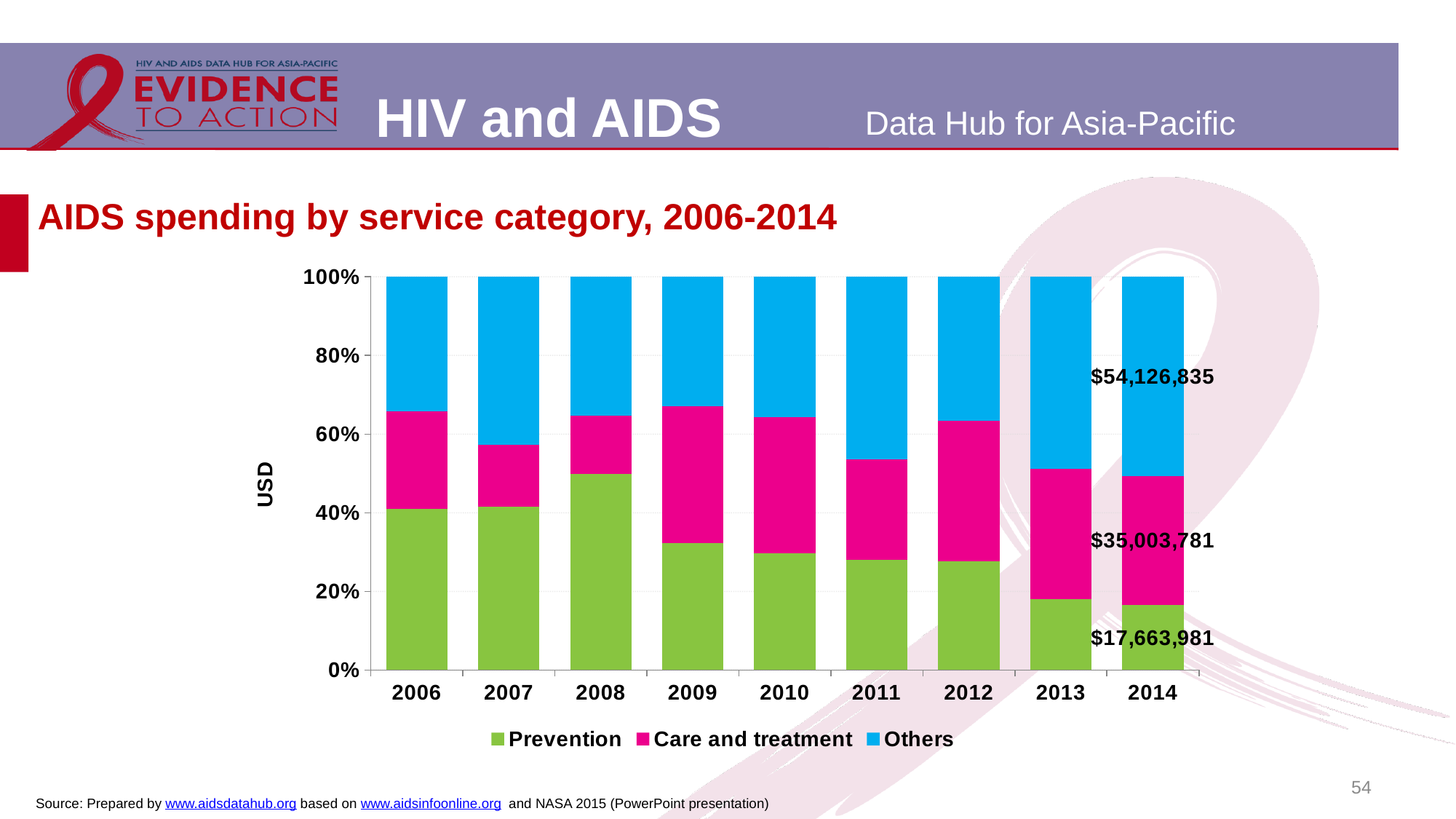
How many series does the legend list? 3 How many years are shown on the x axis of the chart? 9 What is the labelled value for Care and treatment in 2014? $35,003,781 What is the difference between the 2014 values for Others and Prevention? $36,462,854 What kind of chart is shown on the slide? Stacked bar chart Which year has the highest Prevention share of spending? 2008 What is the title of the chart? AIDS spending by service category, 2006-2014 In 2014, which is larger: the value for Others or the value for Prevention? Others What is the labelled value for Prevention in 2014? $17,663,981 Is the Prevention share in 2008 greater or less than 40%? greater What is the labelled value for Others in 2014? $54,126,835 What is the total of the three labelled 2014 values? $106,794,597